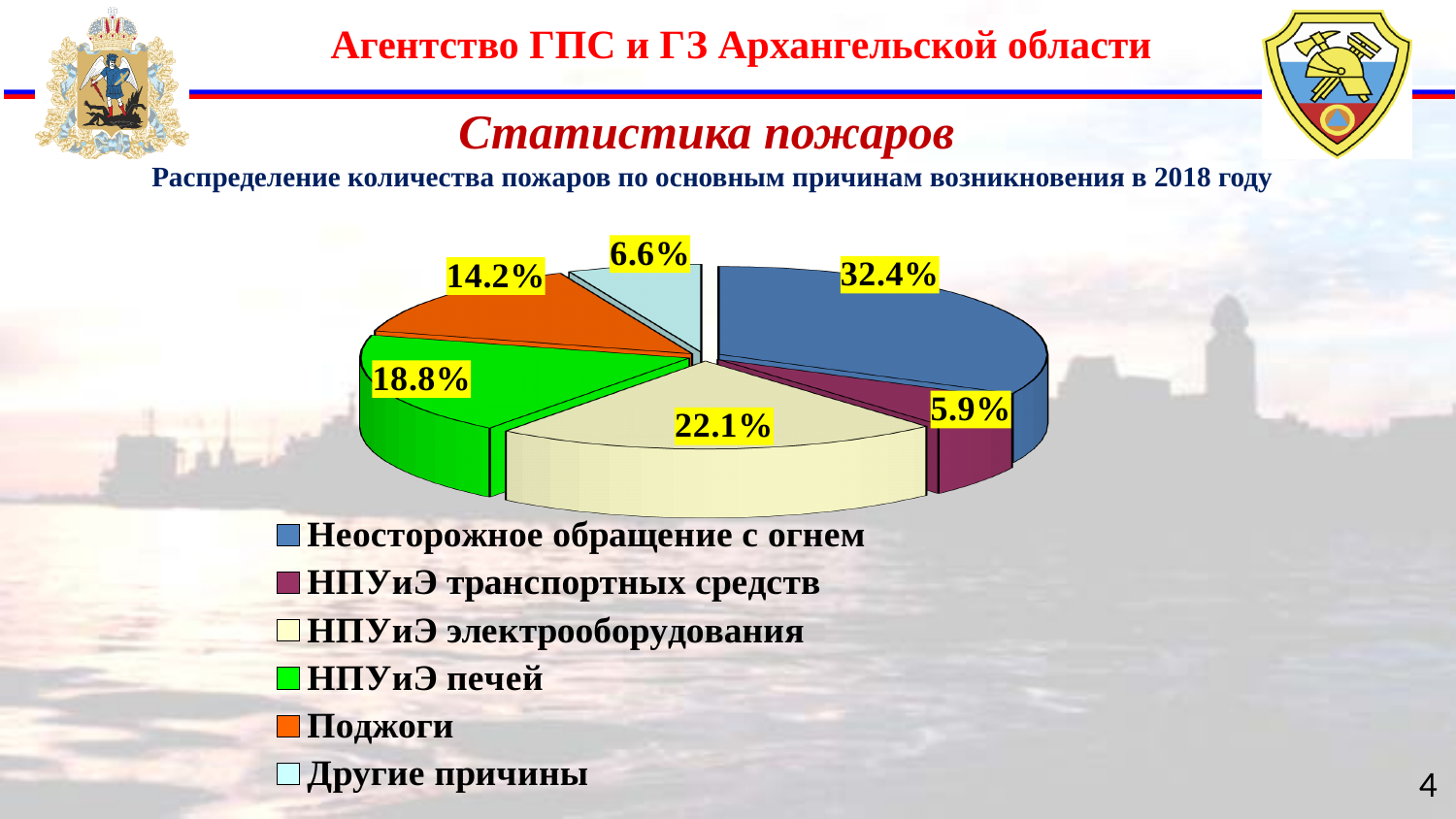
Which cause accounts for the largest share of fires? Неосторожное обращение с огнем Which is larger: the share for "Поджоги" or the share for "Другие причины"? Поджоги Which cause accounts for the smallest share of fires? НПУиЭ транспортных средств How many categories does the pie chart show? 6 What kind of chart is shown on the slide? pie chart What share of fires is attributed to "Другие причины"? 6.6% What share of fires is attributed to "Неосторожное обращение с огнем"? 32.4% What is the difference in percentage points between "Неосторожное обращение с огнем" and "НПУиЭ электрооборудования"? 10.3 What share of fires is attributed to "Поджоги"? 14.2% What share of fires is attributed to "НПУиЭ электрооборудования"? 22.1% What share of fires is attributed to "НПУиЭ печей"? 18.8% What share of fires is attributed to "НПУиЭ транспортных средств"? 5.9%